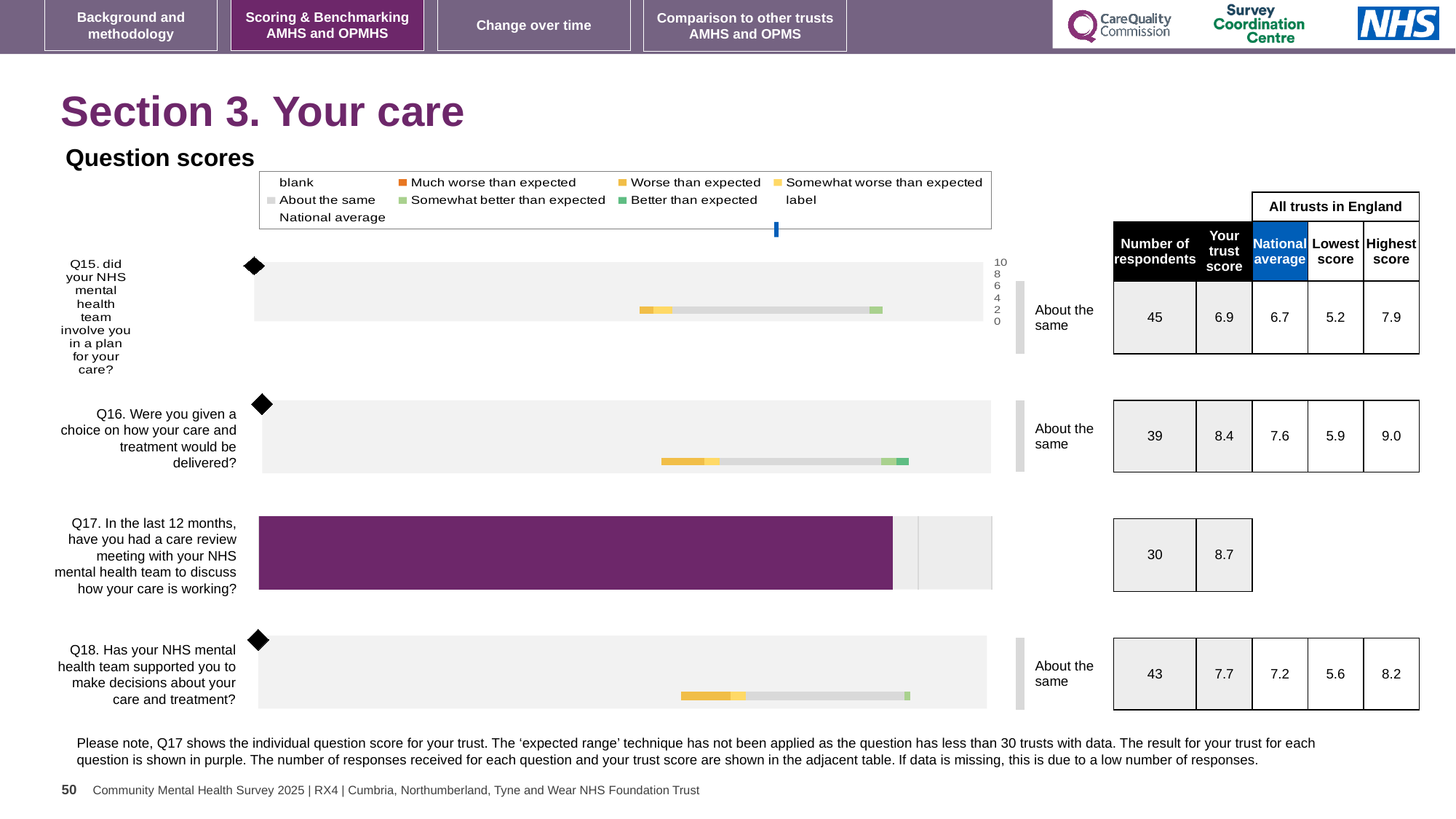
Which question has the lowest trust score on this slide? Q15 Which question has the highest trust score on this slide? Q17 Is the trust score for Q18 higher or lower than the national average for Q18? higher How many respondents answered Q15 (did your NHS mental health team involve you in a plan for your care)? 45 What is the national average score for Q18 (Has your NHS mental health team supported you to make decisions about your care and treatment)? 7.2 What is the difference between the trust score and the national average for Q16? 0.8 How many questions are plotted on the chart? 4 What is the highest score among all trusts in England for Q16? 9.0 What is the trust score for Q16 (Were you given a choice on how your care and treatment would be delivered)? 8.4 What benchmark category is shown for Q15, Q16 and Q18? About the same What kind of chart is used to show the question scores? bar chart Which question's bar is shown in purple because the expected range technique was not applied? Q17